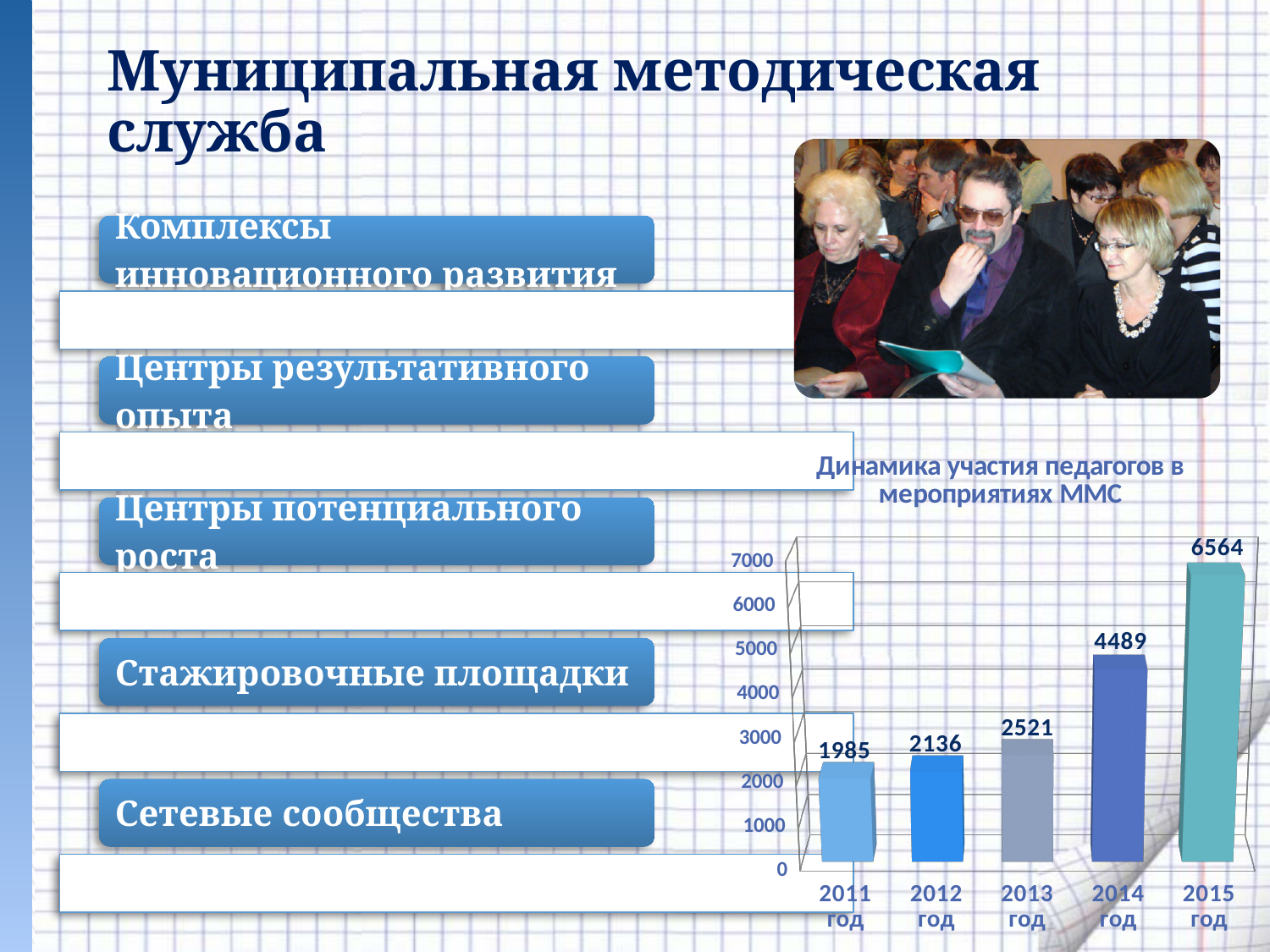
What is the title of the chart? Динамика участия педагогов в мероприятиях ММС What kind of chart is shown on the slide? bar chart Is the value for 2014 год greater or less than 4000? greater What is the difference between the values for 2012 год and 2011 год? 151 What is the value for 2013 год in the chart? 2521 How many years are shown in the chart? 5 Which year has the lowest value in the chart? 2011 год What is the difference between the values for 2015 год and 2014 год? 2075 What is the value for 2011 год in the chart? 1985 What is the value for 2015 год in the chart? 6564 Which is larger, the value for 2014 год or the value for 2013 год? 2014 год Which year has the highest value in the chart? 2015 год